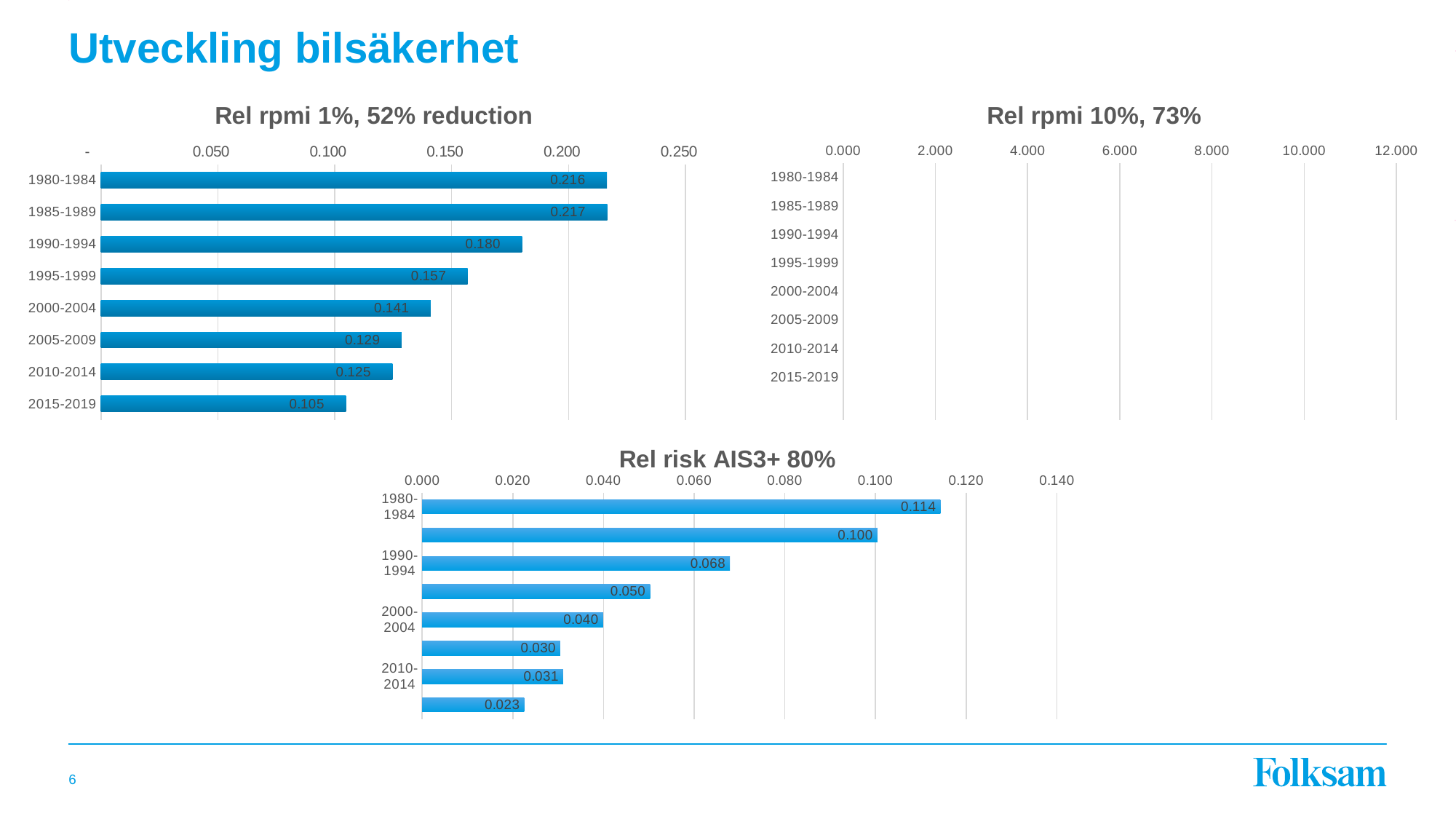
In the chart titled "Rel rpmi 1%, 52% reduction", how many periods are shown? 8 In the chart titled "Rel rpmi 1%, 52% reduction", what is the difference between the values for 1990-1994 and 1995-1999? 0.023 In the chart titled "Rel rpmi 1%, 52% reduction", which period has the lowest value? 2015-2019 In the chart titled "Rel rpmi 1%, 52% reduction", what is the value for 2015-2019? 0.105 In the chart titled "Rel risk AIS3+ 80%", which is larger, the value for 1990-1994 or the value for 2010-2014? 1990-1994 In the chart titled "Rel risk AIS3+ 80%", what is the value for 2000-2004? 0.040 In the chart titled "Rel rpmi 1%, 52% reduction", which period has the highest value? 1985-1989 In the chart titled "Rel risk AIS3+ 80%", what is the value for 1980-1984? 0.114 In the chart titled "Rel rpmi 1%, 52% reduction", what is the value for 1980-1984? 0.216 In the chart titled "Rel rpmi 1%, 52% reduction", do the values generally rise or fall from 1980-1984 to 2015-2019? fall What kind of chart is the one titled "Rel risk AIS3+ 80%"? bar chart In the chart titled "Rel risk AIS3+ 80%", is the value for 1980-1984 greater or less than 0.100? greater